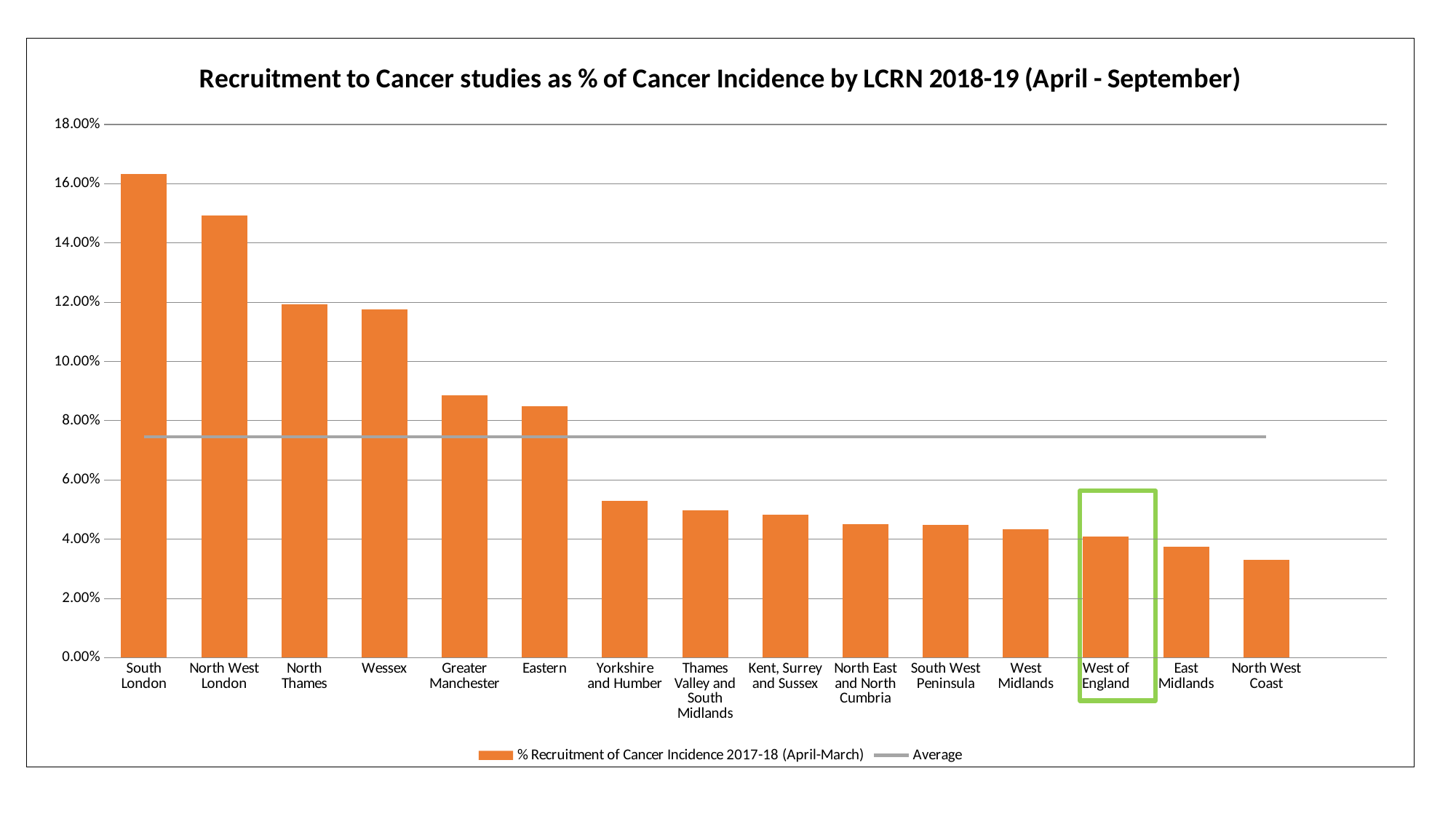
What kind of chart is shown on the slide? bar chart Which LCRN has the lowest recruitment as % of cancer incidence? North West Coast Which LCRN's bar is highlighted with a green box? West of England Which LCRN has the highest recruitment as % of cancer incidence? South London Is the value for Yorkshire and Humber greater or less than 6.00%? less Is the value for Wessex greater or less than 10.00%? greater Is the value for North West Coast greater or less than 4.00%? less How many LCRN categories are plotted on the x axis? 15 Do the bar values rise or fall moving from left to right along the x axis? fall How many entries does the legend list? 2 Which is larger, the value for Eastern or the value for Yorkshire and Humber? Eastern